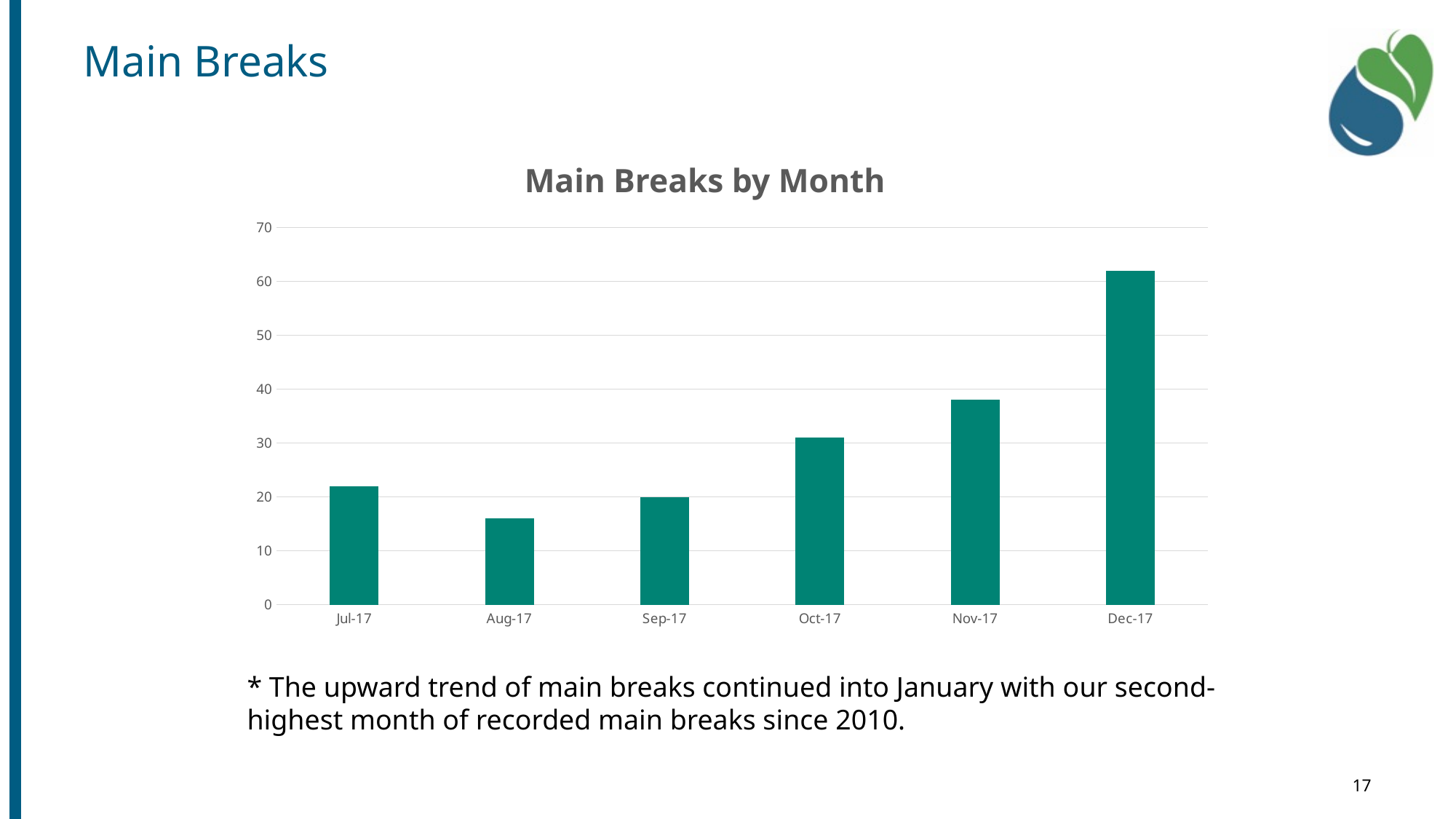
Is the value for Dec-17 greater or less than 50? greater Is the value for Nov-17 greater or less than 30? greater What kind of chart is shown on the slide? Bar chart Is the value for Aug-17 greater or less than 20? less Do the values rise or fall from Sep-17 to Dec-17? rise Which is larger, the value for Nov-17 or the value for Oct-17? Nov-17 Which month has the lowest number of main breaks? Aug-17 Which month has the highest number of main breaks? Dec-17 How many months are shown on the x axis of the chart? 6 What is the title of the chart? Main Breaks by Month What is the value for Sep-17? 20